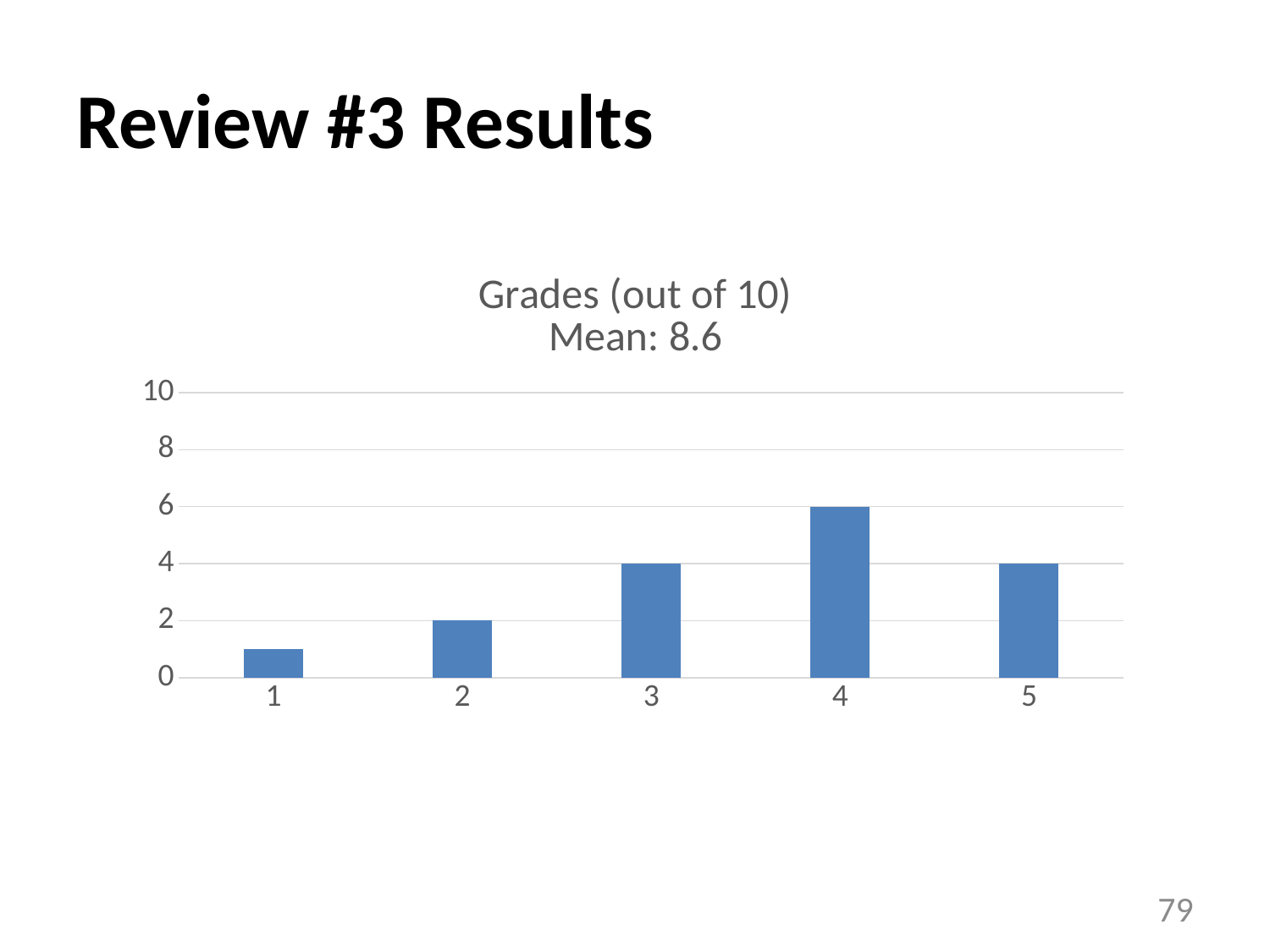
Which is larger, the value for category 4 or the value for category 3? category 4 Which category has the lowest bar in the chart? 1 What is the value for category 5? 4 Which category has the highest bar in the chart? 4 What is the value for category 2? 2 What type of chart is shown on the slide? bar chart Is the value for category 1 greater or less than 2? less What is the difference between the values for category 4 and category 2? 4 What mean value is stated in the chart title? 8.6 What is the value for category 3? 4 What is the value for category 4? 6 How many categories are shown on the x axis of the chart? 5